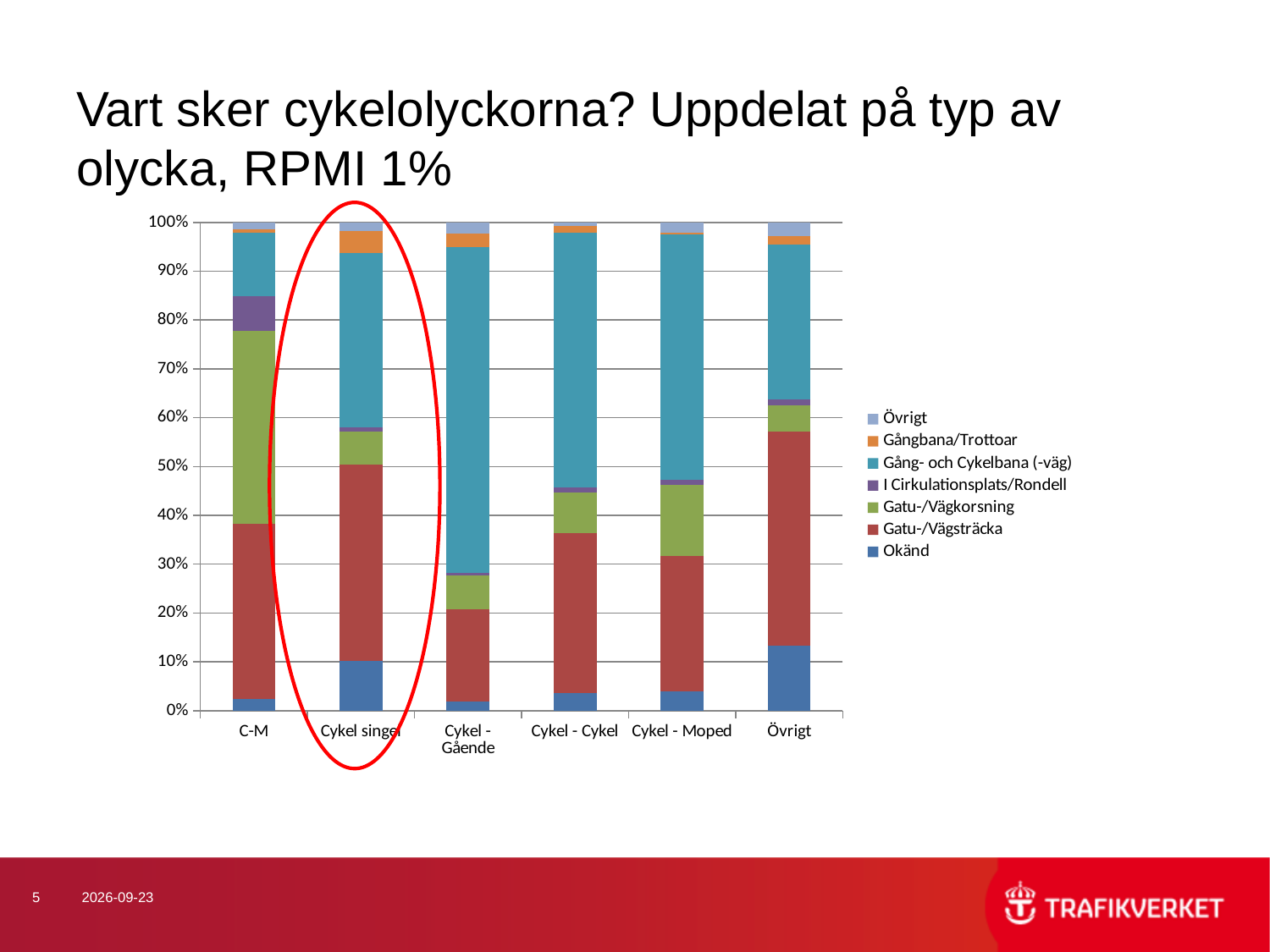
Is the Gång- och Cykelbana (-väg) share for Cykel - Gående greater or less than 60%? greater Is the Okänd share for Övrigt greater or less than 10%? greater Which category is circled in red on the chart? Cykel singel How many categories are shown on the x axis of the chart? 6 Is the Okänd share for C-M greater or less than 10%? less Which has the larger Gatu-/Vägsträcka share, Övrigt or Cykel - Gående? Övrigt Which category has the largest Gatu-/Vägkorsning share? C-M How many series does the chart's legend list? 7 Which category has the largest Okänd share? Övrigt Which series is plotted at the bottom of each stacked bar? Okänd What kind of chart is shown on the slide? Stacked bar chart